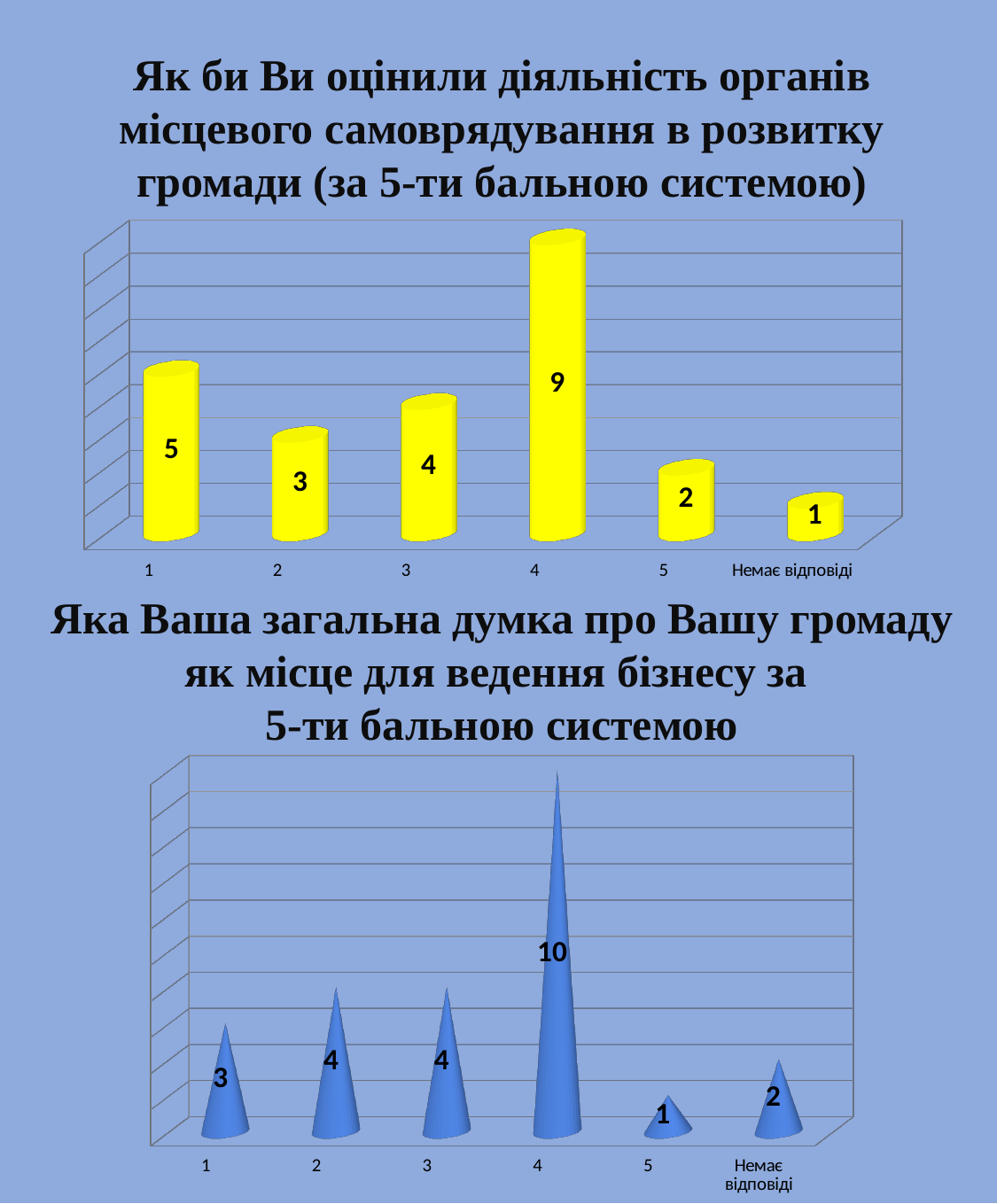
In the top chart, what is the value for category 4? 9 In the bottom chart, what is the difference between the values for category 4 and "Немає відповіді"? 8 In the bottom chart, what is the value for category 4? 10 In the top chart, what is the value for "Немає відповіді"? 1 In the bottom chart, what is the value for category 5? 1 What kind of chart is the top chart? bar chart In the bottom chart, which is larger: the value for category 1 or the value for category 2? category 2 In the top chart, how many categories are shown on the x axis? 6 In the top chart, which category has the highest value? 4 In the top chart, which category has the lowest value? Немає відповіді In the top chart, what is the difference between the values for category 4 and category 1? 4 In the bottom chart, which category has the lowest value? 5